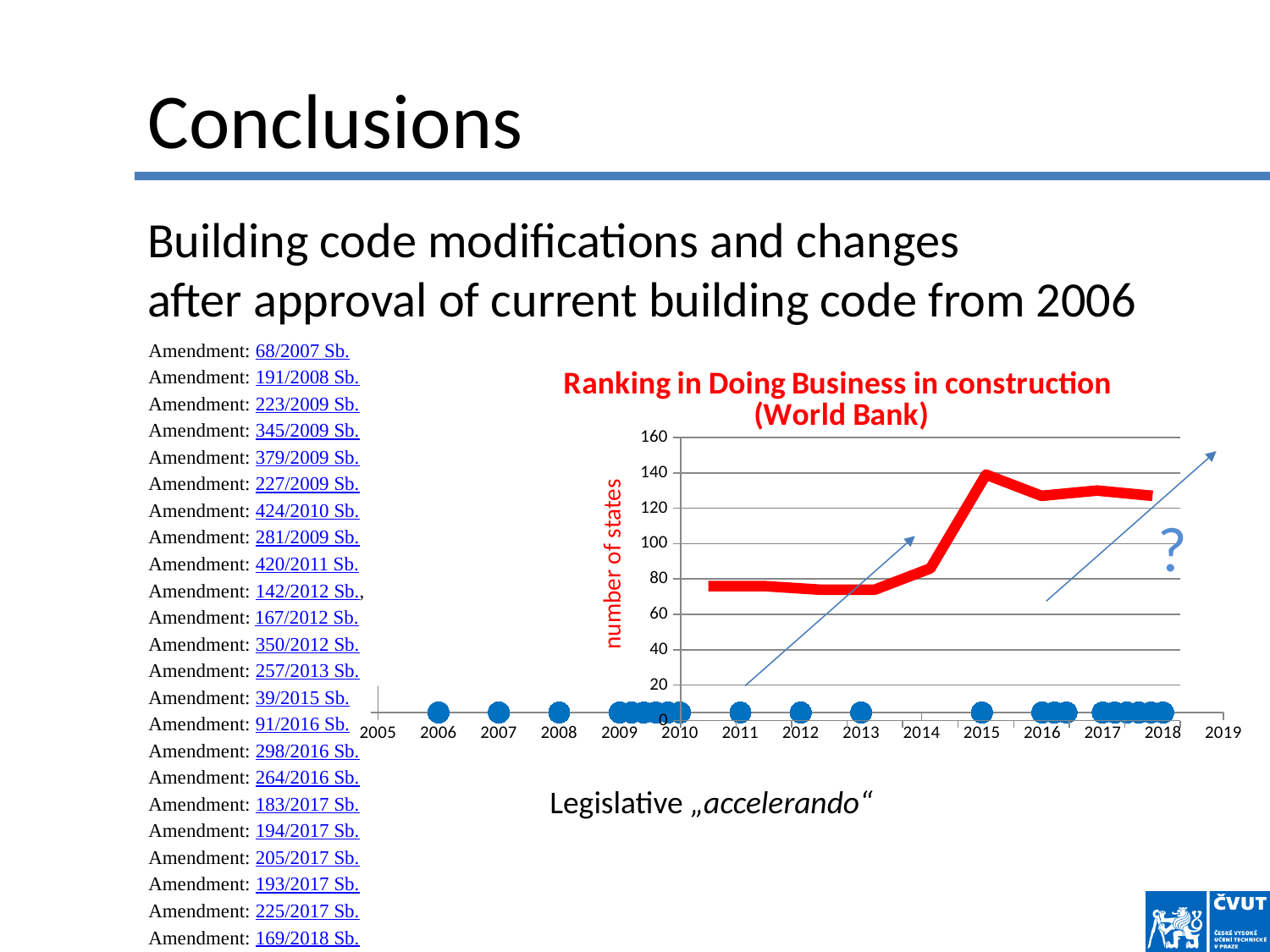
What is the title of the chart? Ranking in Doing Business in construction (World Bank) Is the value of the red line for 2014 greater or less than 100? less Is the value of the red line for 2016 greater or less than 100? greater Does the red line rise or fall between 2013 and 2015? rise Is the value of the red line for 2015 greater or less than 120? greater What is the label on the vertical axis of the chart? number of states In which year does the red line reach its highest value? 2015 What is the highest value shown on the vertical axis? 160 Which year has the larger value on the red line, 2013 or 2015? 2015 What kind of chart is shown on the slide? line chart